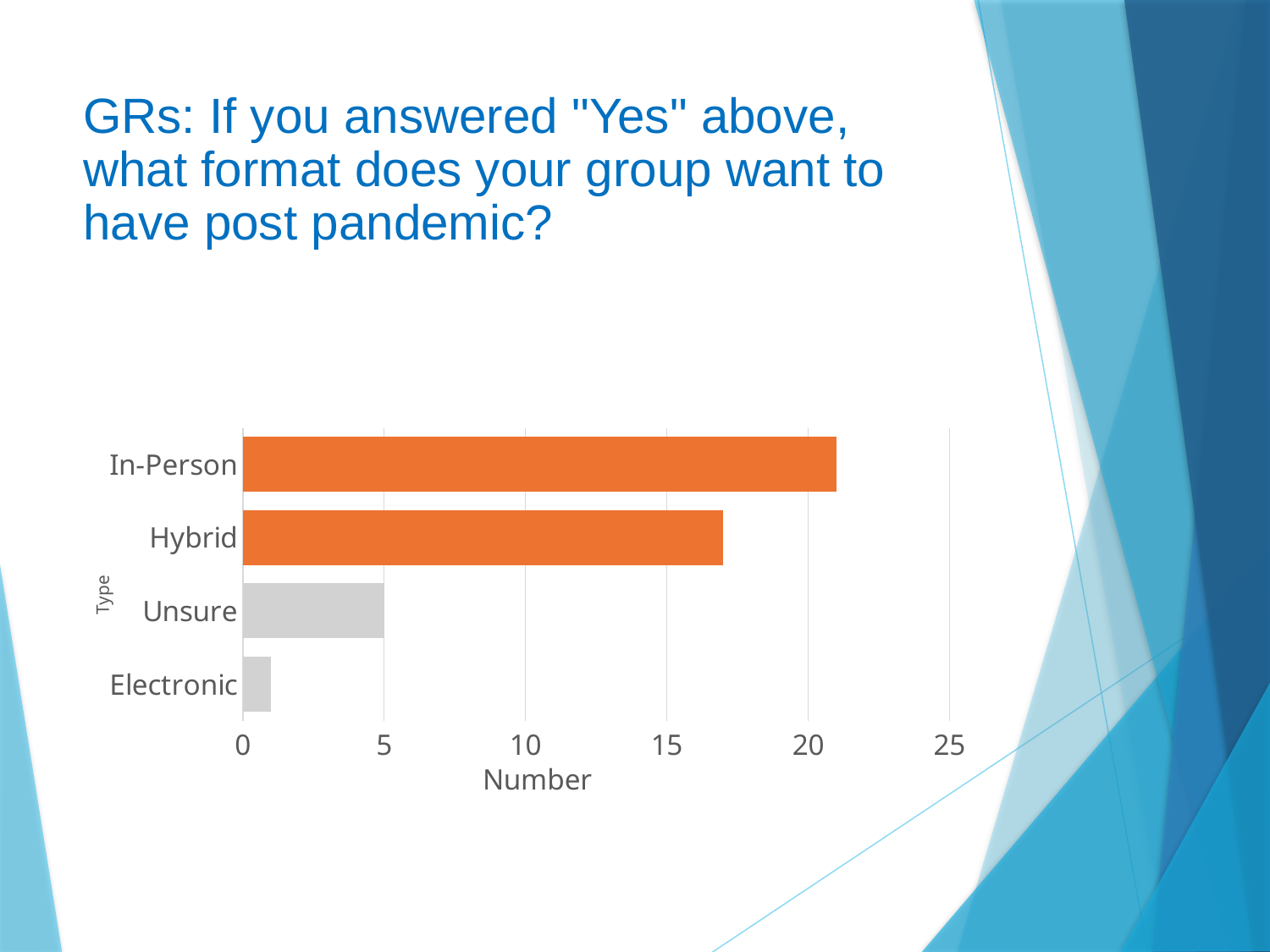
What is the title of the horizontal axis? Number Is the value for Hybrid greater or less than 20? less Which is larger, the value for In-Person or the value for Hybrid? In-Person How many categories are shown on the chart? 4 What kind of chart is shown on the slide? bar chart Is the value for Hybrid greater or less than 15? greater Which is larger, the value for Unsure or the value for Electronic? Unsure What is the value for Unsure? 5 Which category has the lowest value? Electronic Is the value for Electronic greater or less than 5? less Which category has the highest value? In-Person